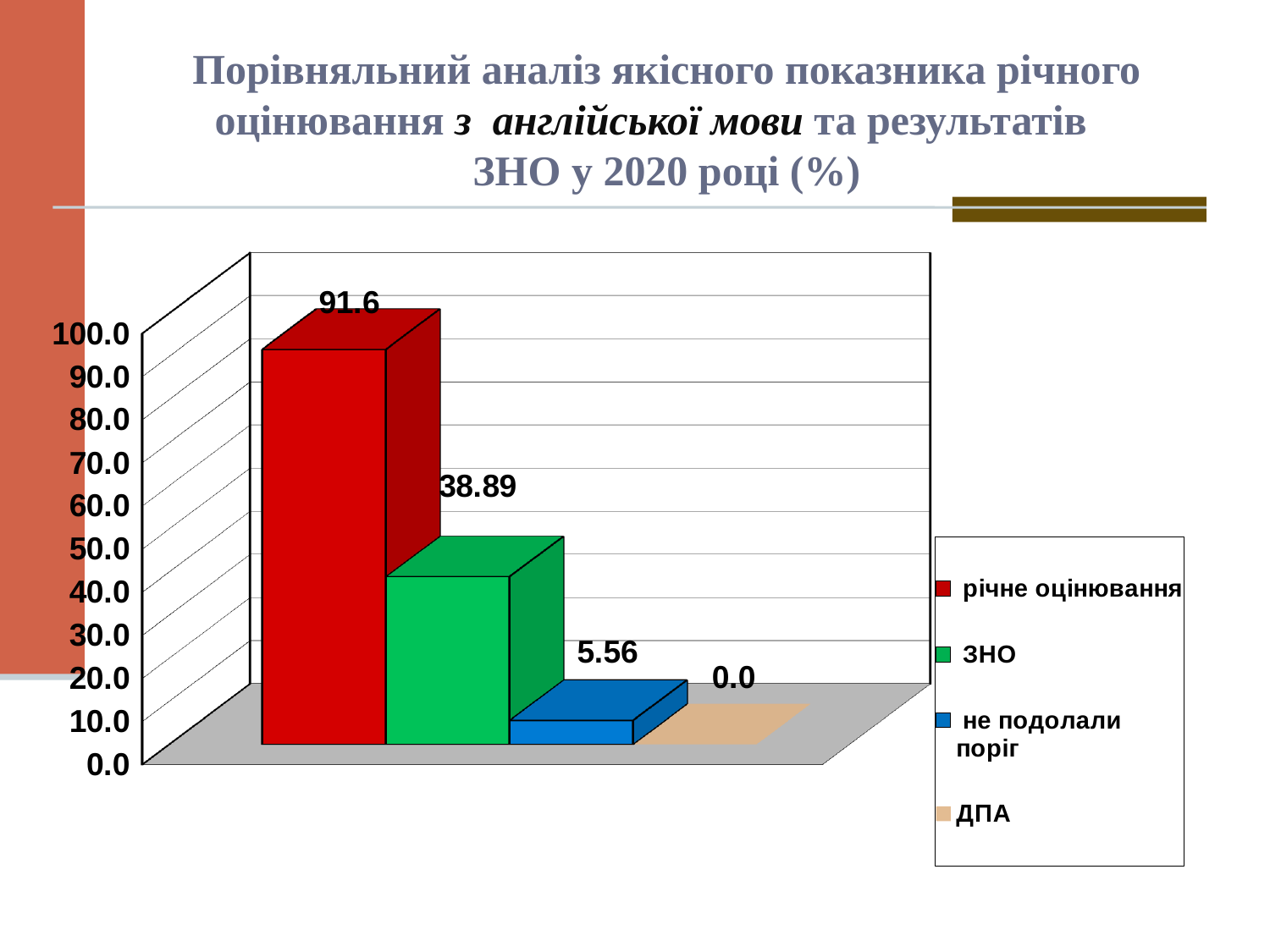
What kind of chart is shown on the slide? bar chart What is the value for не подолали поріг? 5.56 What is the value for річне оцінювання? 91.6 Which series has the lowest value? ДПА What is the value for ДПА? 0.0 Is the value for ЗНО greater or less than 50.0? less What colour is the bar for ЗНО? green Which series has the highest value? річне оцінювання What is the value for ЗНО? 38.89 What is the difference between the values for річне оцінювання and ЗНО? 52.71 How many series does the legend list? 4 Which is larger, the value for ЗНО or the value for не подолали поріг? ЗНО